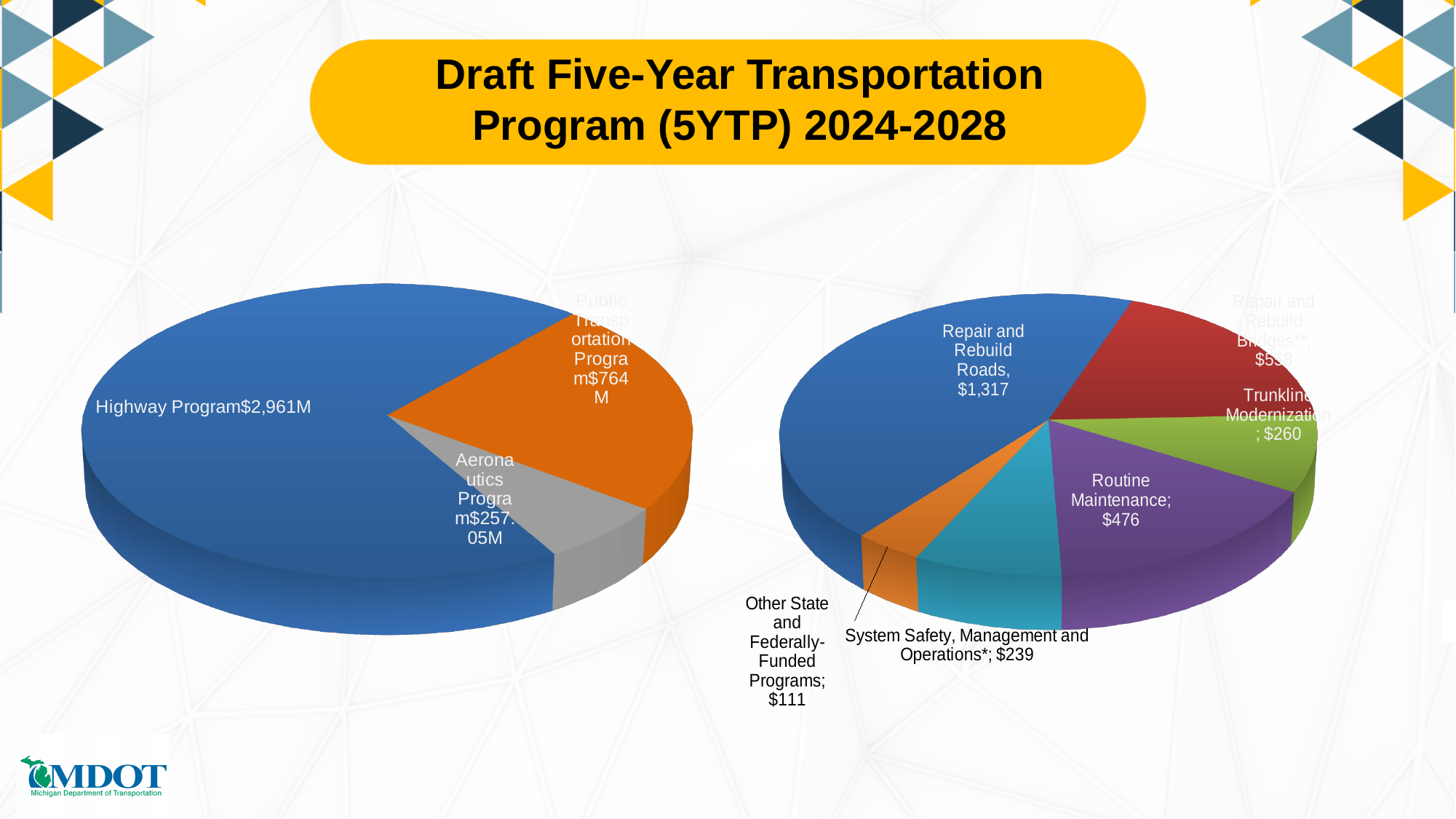
In the right pie chart, what is the value for Other State and Federally-Funded Programs? $111 In the left pie chart, what is the value for the Aeronautics Program? $257.05M How many slices does the left pie chart have? 3 In the left pie chart, what is the value for the Highway Program? $2,961M In the right pie chart, which is larger: Trunkline Modernization or System Safety, Management and Operations*? Trunkline Modernization In the left pie chart, which program has the largest slice? Highway Program What type of chart is the left chart on the slide? pie chart In the right pie chart, what is the difference between Routine Maintenance and System Safety, Management and Operations*? $237 In the right pie chart, what is the value for Routine Maintenance? $476 In the left pie chart, which program has the smallest slice? Aeronautics Program In the left pie chart, what is the value for the Public Transportation Program? $764M In the right pie chart, what is the value for Repair and Rebuild Roads? $1,317